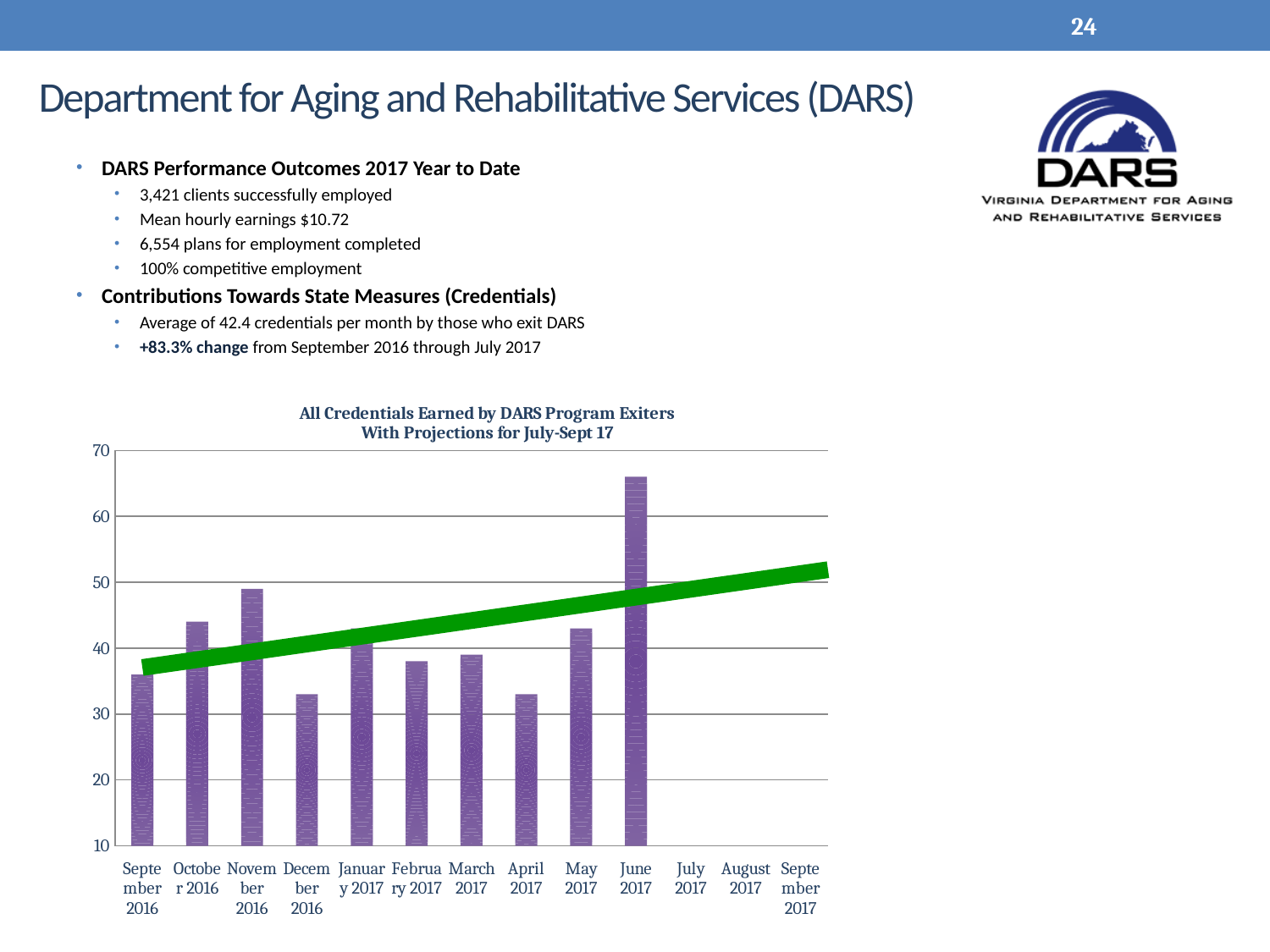
What kind of chart is shown on the slide? bar chart Does the green trend line rise or fall from left to right across the chart? rise What is the title of the chart? All Credentials Earned by DARS Program Exiters With Projections for July-Sept 17 Which is larger, the value for December 2016 or the value for November 2016? November 2016 How many months have a bar plotted in the chart? 10 Is the value for June 2017 greater or less than 60? greater Is the value for October 2016 greater or less than 40? greater Is the value for December 2016 greater or less than 40? less Which is larger, the value for November 2016 or the value for October 2016? November 2016 Which month has the highest bar in the chart? June 2017